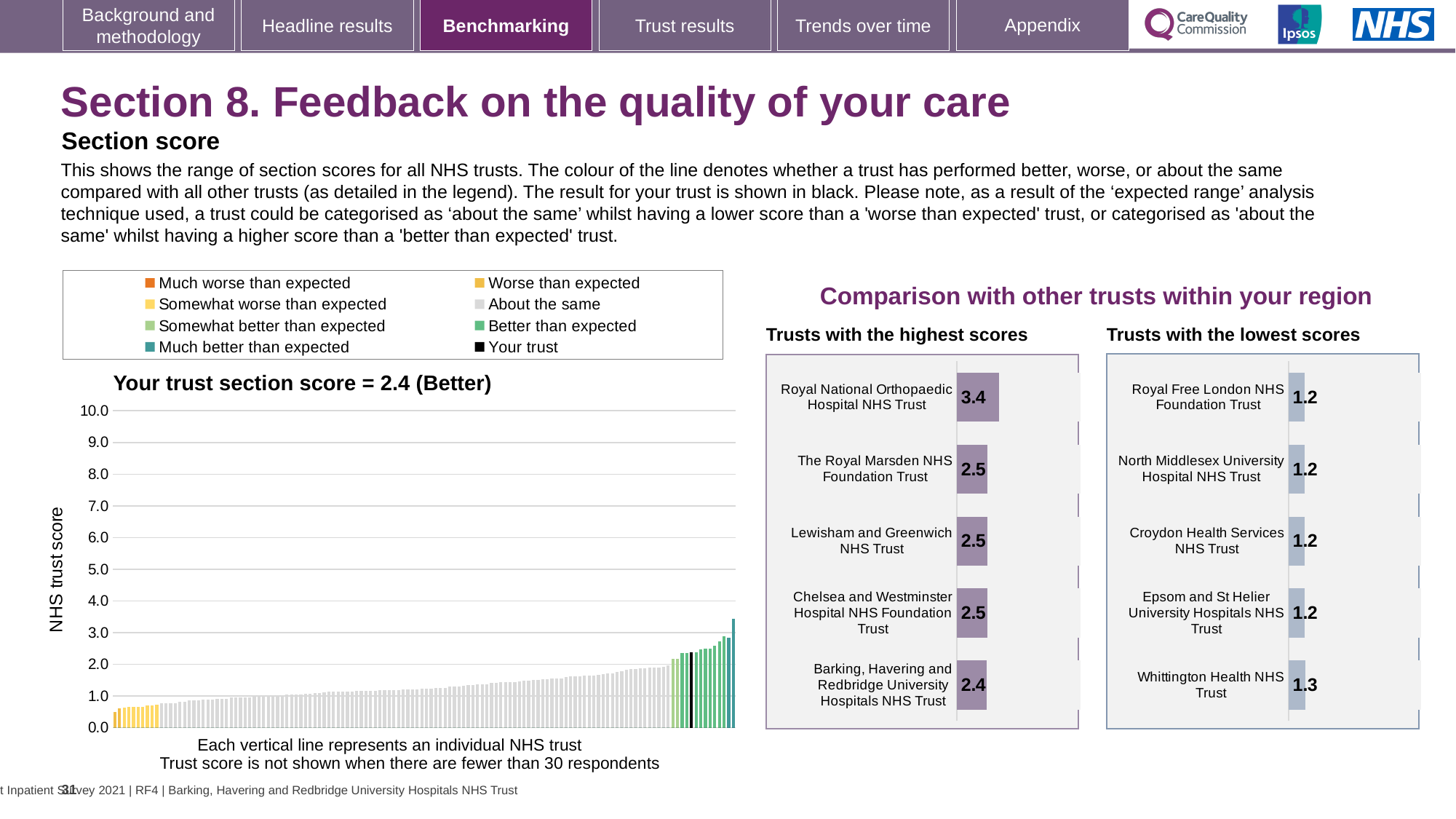
In the 'Trusts with the highest scores' chart, which is larger: the score for The Royal Marsden NHS Foundation Trust or the score for Barking, Havering and Redbridge University Hospitals NHS Trust? The Royal Marsden NHS Foundation Trust In the 'Your trust section score' chart, is the value of the tallest bar greater or less than 4.0? less In the 'Trusts with the highest scores' chart, which trust has the highest score? Royal National Orthopaedic Hospital NHS Trust In the 'Your trust section score' chart, do the trust scores rise or fall from left to right along the x axis? rise In the 'Trusts with the lowest scores' chart, what is the difference between the scores of Whittington Health NHS Trust and Croydon Health Services NHS Trust? 0.1 How many entries does the legend above the 'Your trust section score' chart list? 8 In the 'Trusts with the highest scores' chart, what is the score for Barking, Havering and Redbridge University Hospitals NHS Trust? 2.4 In the 'Trusts with the lowest scores' chart, how many trusts are shown? 5 In the 'Trusts with the highest scores' chart, what is the difference between the scores of Royal National Orthopaedic Hospital NHS Trust and Barking, Havering and Redbridge University Hospitals NHS Trust? 1.0 In the 'Trusts with the lowest scores' chart, what is the score for Whittington Health NHS Trust? 1.3 In the 'Trusts with the highest scores' chart, what is the score for Royal National Orthopaedic Hospital NHS Trust? 3.4 According to the title of the 'Your trust section score' chart, what is your trust's section score? 2.4 (Better)